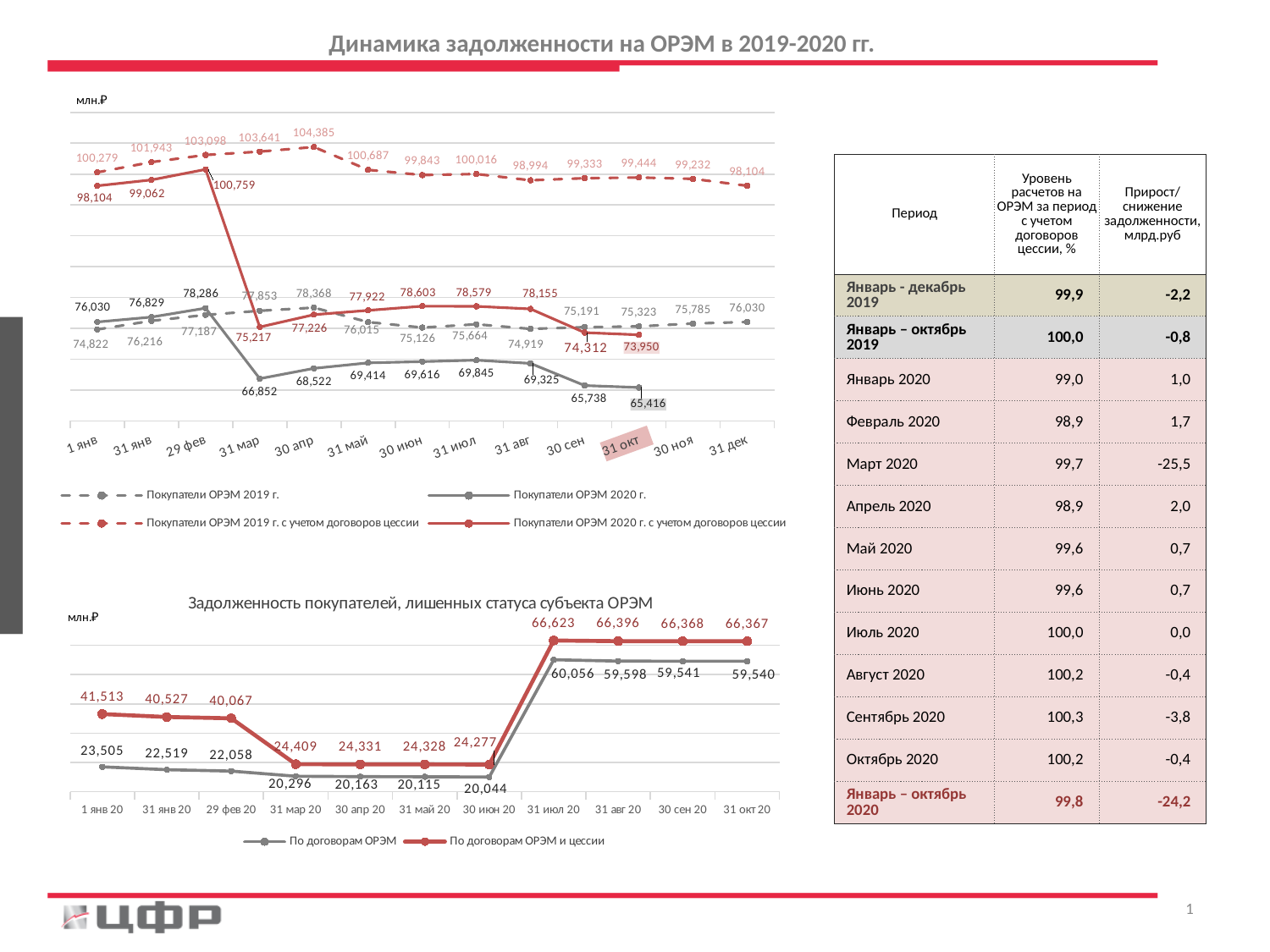
In the top chart on the slide, which is larger on 31 мар: 'Покупатели ОРЭМ 2019 г.' or 'Покупатели ОРЭМ 2020 г.'? Покупатели ОРЭМ 2019 г. In the top chart on the slide, what is the value for 'Покупатели ОРЭМ 2019 г. с учетом договоров цессии' on 30 апр? 104,385 In the bottom chart 'Задолженность покупателей, лишенных статуса субъекта ОРЭМ', at which date is the 'По договорам ОРЭМ' series lowest? 30 июн 20 What kind of chart is the bottom chart 'Задолженность покупателей, лишенных статуса субъекта ОРЭМ'? Line chart In the bottom chart 'Задолженность покупателей, лишенных статуса субъекта ОРЭМ', how many series does the legend list? 2 In the bottom chart 'Задолженность покупателей, лишенных статуса субъекта ОРЭМ', what is the difference between 'По договорам ОРЭМ и цессии' and 'По договорам ОРЭМ' on 31 июл 20? 6,567 In the bottom chart 'Задолженность покупателей, лишенных статуса субъекта ОРЭМ', what is the value for 'По договорам ОРЭМ и цессии' on 31 окт 20? 66,367 In the top chart on the slide, what is the value for 'Покупатели ОРЭМ 2020 г. с учетом договоров цессии' on 29 фев? 100,759 In the bottom chart 'Задолженность покупателей, лишенных статуса субъекта ОРЭМ', at which date is the 'По договорам ОРЭМ и цессии' series highest? 31 июл 20 In the bottom chart 'Задолженность покупателей, лишенных статуса субъекта ОРЭМ', what is the value for 'По договорам ОРЭМ' on 1 янв 20? 23,505 In the top chart on the slide, what is the value for 'Покупатели ОРЭМ 2020 г.' on 31 окт? 65,416 In the top chart on the slide, how many series does the legend list? 4